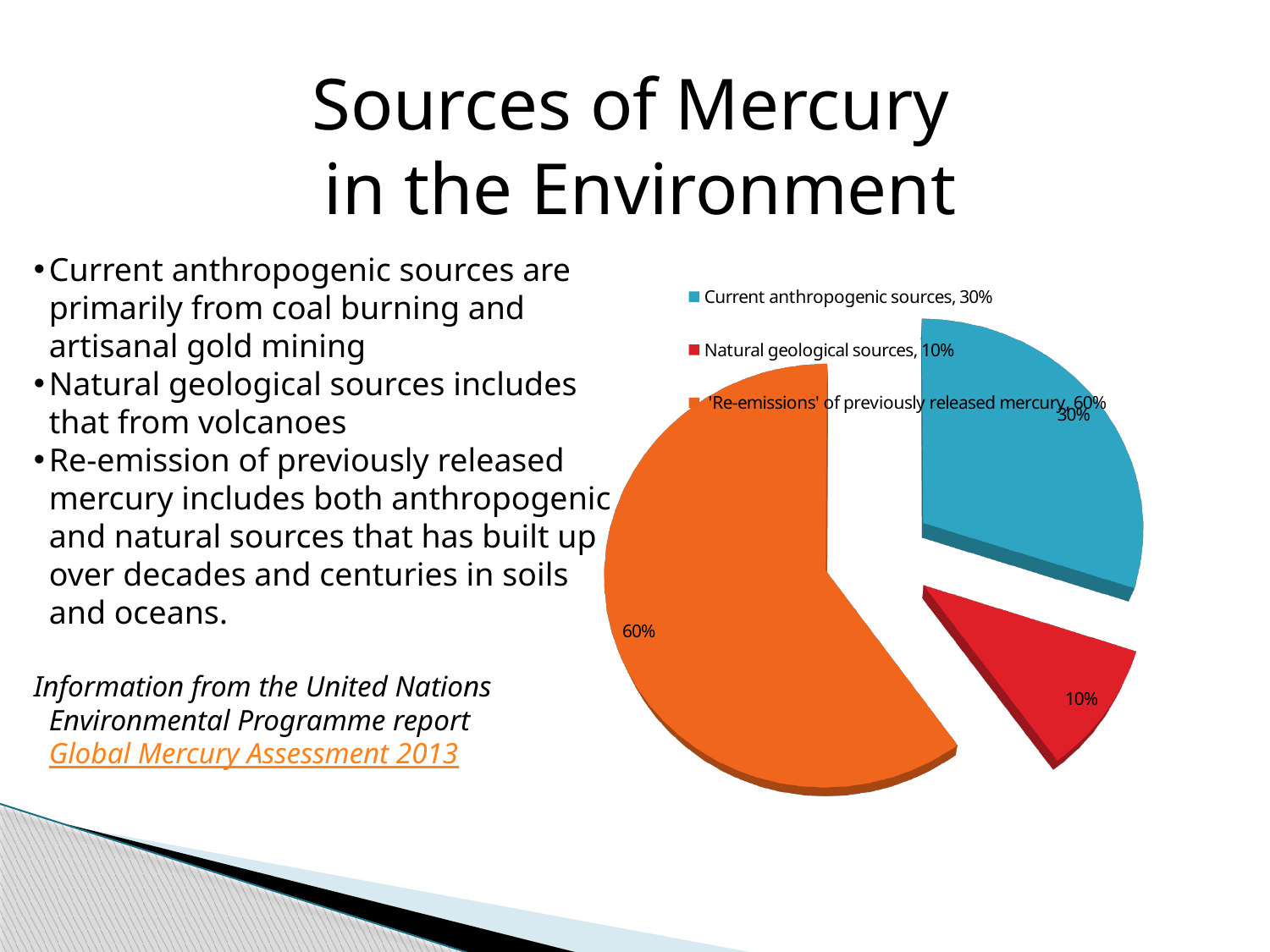
What share of the pie is Natural geological sources? 10% How many entries does the legend list? 3 How many slices does the pie chart have? 3 Which source has the smallest slice of the pie? Natural geological sources What is the difference in percentage points between 'Re-emissions' of previously released mercury and Current anthropogenic sources? 30 Which source has the largest slice of the pie? 'Re-emissions' of previously released mercury What share of the pie is 'Re-emissions' of previously released mercury? 60% What kind of chart is shown on the slide? pie chart What share of the pie is Current anthropogenic sources? 30% What is the difference in percentage points between Current anthropogenic sources and Natural geological sources? 20 What colour is the slice for Natural geological sources? red Which is larger, Current anthropogenic sources or Natural geological sources? Current anthropogenic sources